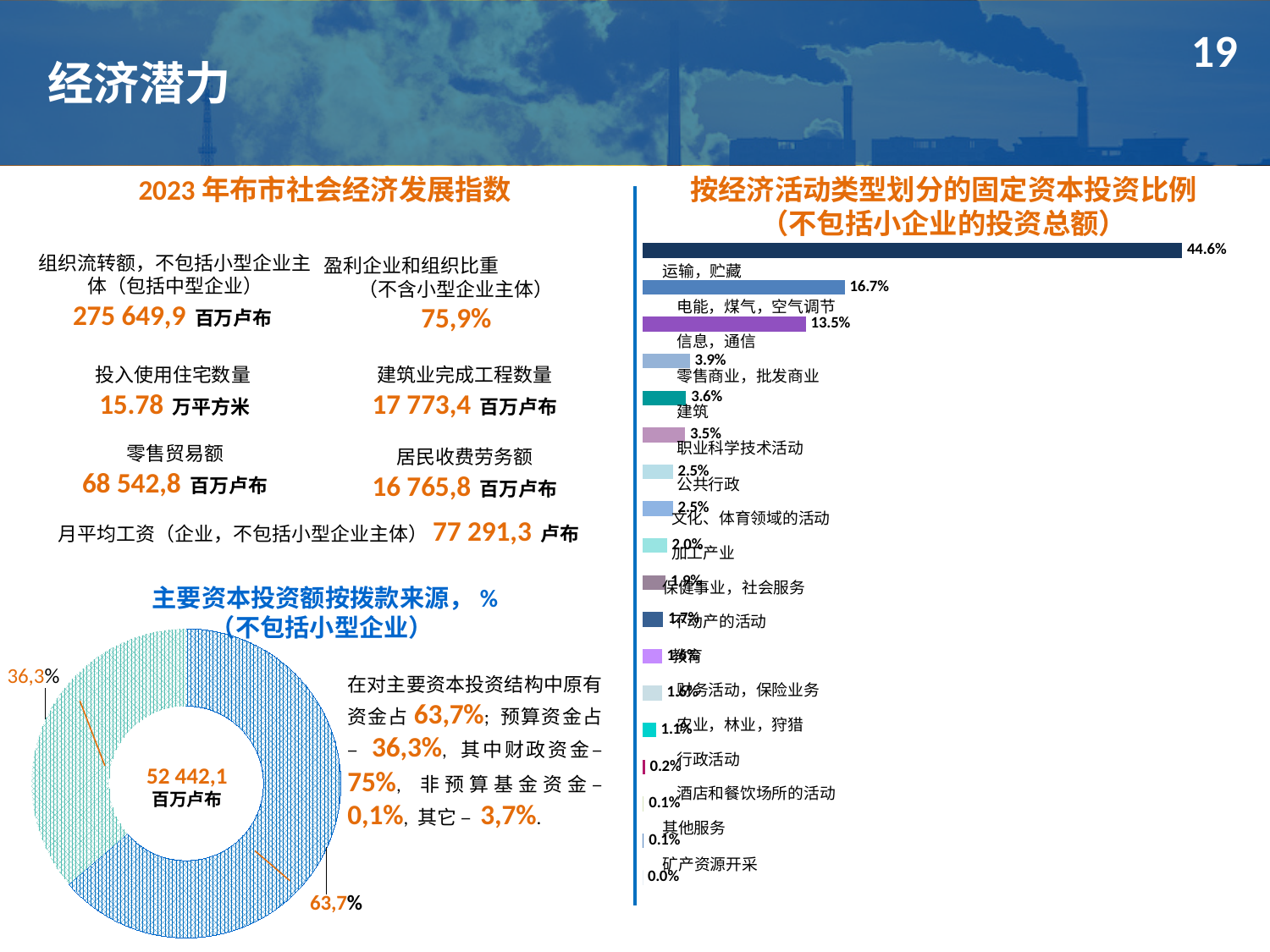
What value is shown in the centre of the donut chart 主要资本投资额按拨款来源? 52 442,1 百万卢布 In the bar chart 按经济活动类型划分的固定资本投资比例, which is larger, 零售商业，批发商业 or 建筑? 零售商业，批发商业 In the bar chart 按经济活动类型划分的固定资本投资比例, what is the value for 运输，贮藏? 44.6% In the bar chart 按经济活动类型划分的固定资本投资比例, what is the difference between 运输，贮藏 and 电能，煤气，空气调节? 27.9% In the donut chart 主要资本投资额按拨款来源, what share does the smaller slice have? 36,3% In the bar chart 按经济活动类型划分的固定资本投资比例, which category has the highest value? 运输，贮藏 What kind of chart is 按经济活动类型划分的固定资本投资比例? Bar chart In the donut chart 主要资本投资额按拨款来源, what share does the larger slice have? 63,7% In the bar chart 按经济活动类型划分的固定资本投资比例, what is the value for 电能，煤气，空气调节? 16.7% In the bar chart 按经济活动类型划分的固定资本投资比例, what is the value for 信息，通信? 13.5% In the bar chart 按经济活动类型划分的固定资本投资比例, what is the value for 农业，林业，狩猎? 1.1% In the bar chart 按经济活动类型划分的固定资本投资比例, which category has the lowest value? 矿产资源开采